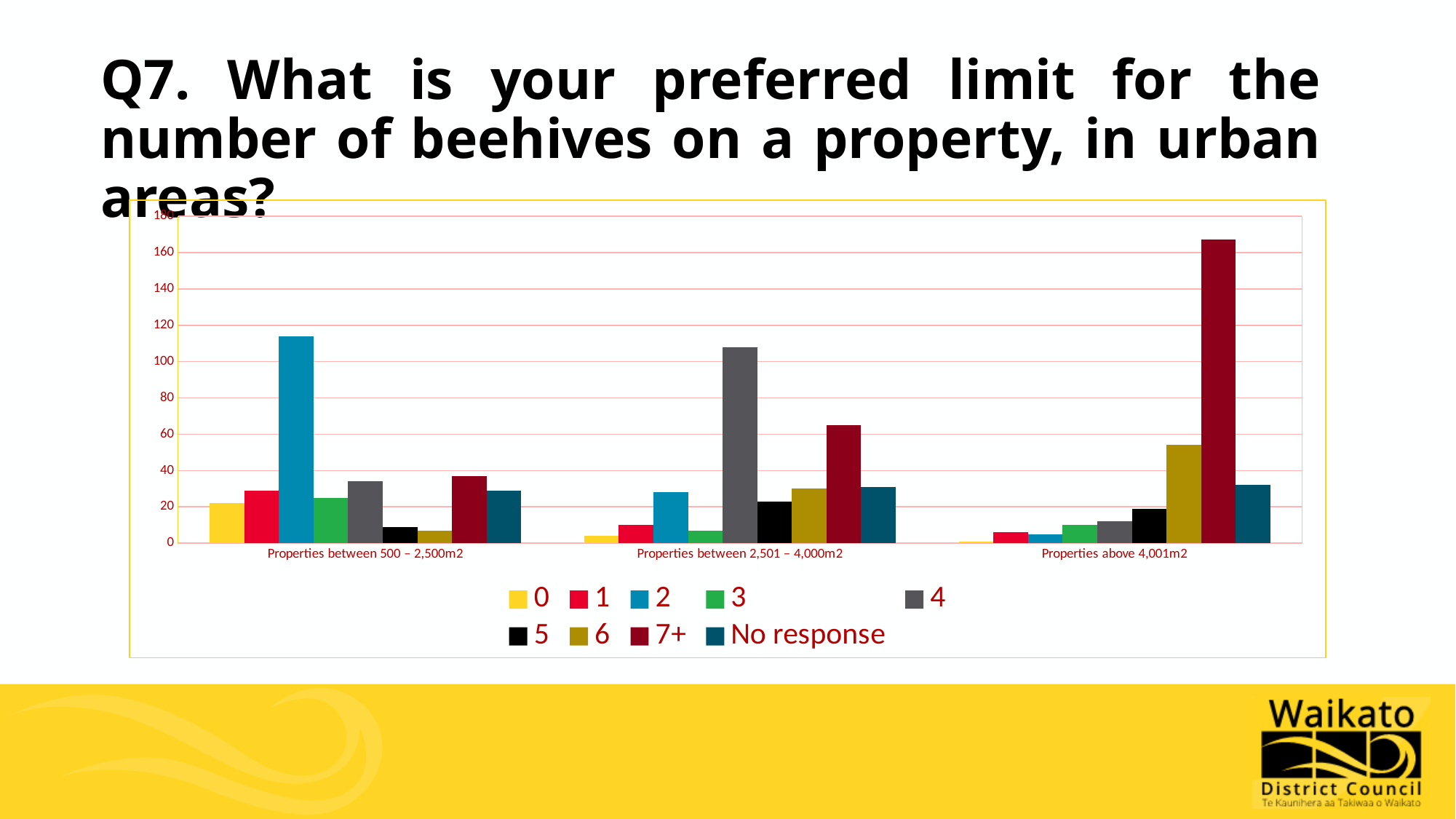
Which is larger: the '7+' bar for 'Properties between 2,501 – 4,000m2' or the '4' bar for 'Properties between 500 – 2,500m2'? the '7+' bar for Properties between 2,501 – 4,000m2 How many property-size categories are shown on the x axis? 3 For 'Properties between 2,501 – 4,000m2', which series has the highest bar? 4 Is the value for '2' in 'Properties between 500 – 2,500m2' greater or less than 100? greater What is the last entry listed in the legend? No response For 'Properties between 500 – 2,500m2', which series has the highest bar? 2 For 'Properties above 4,001m2', which series has the lowest bar? 0 How many series does the legend list? 9 For 'Properties above 4,001m2', which series has the highest bar? 7+ Is the value for '7+' in 'Properties above 4,001m2' greater or less than 160? greater Is the value for '4' in 'Properties between 2,501 – 4,000m2' greater or less than 100? greater What kind of chart is shown on the slide? bar chart